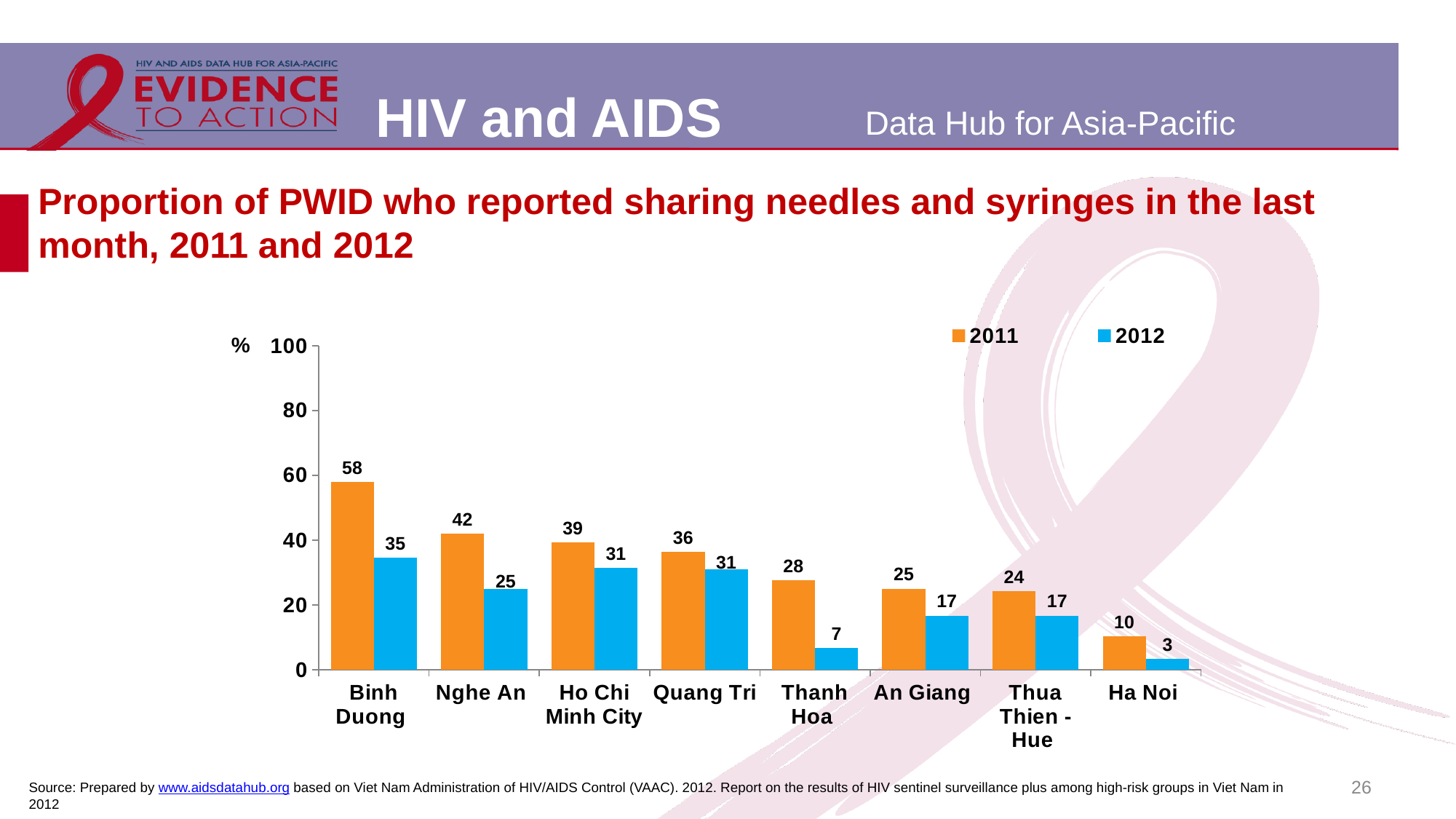
Which province has the highest 2011 value? Binh Duong What is the 2011 value for Binh Duong? 58 How many provinces are shown on the x axis? 8 Which colour represents the 2012 series? Blue Which is larger, the 2012 value for Ho Chi Minh City or the 2012 value for An Giang? Ho Chi Minh City Is the 2011 value for Quang Tri greater or less than 20? greater What is the difference between the 2011 and 2012 values for Nghe An? 17 What kind of chart is shown on the slide? Bar chart What is the 2012 value for Thanh Hoa? 7 Which province has the lowest 2012 value? Ha Noi What is the 2012 value for Ha Noi? 3 How many series does the legend list? 2